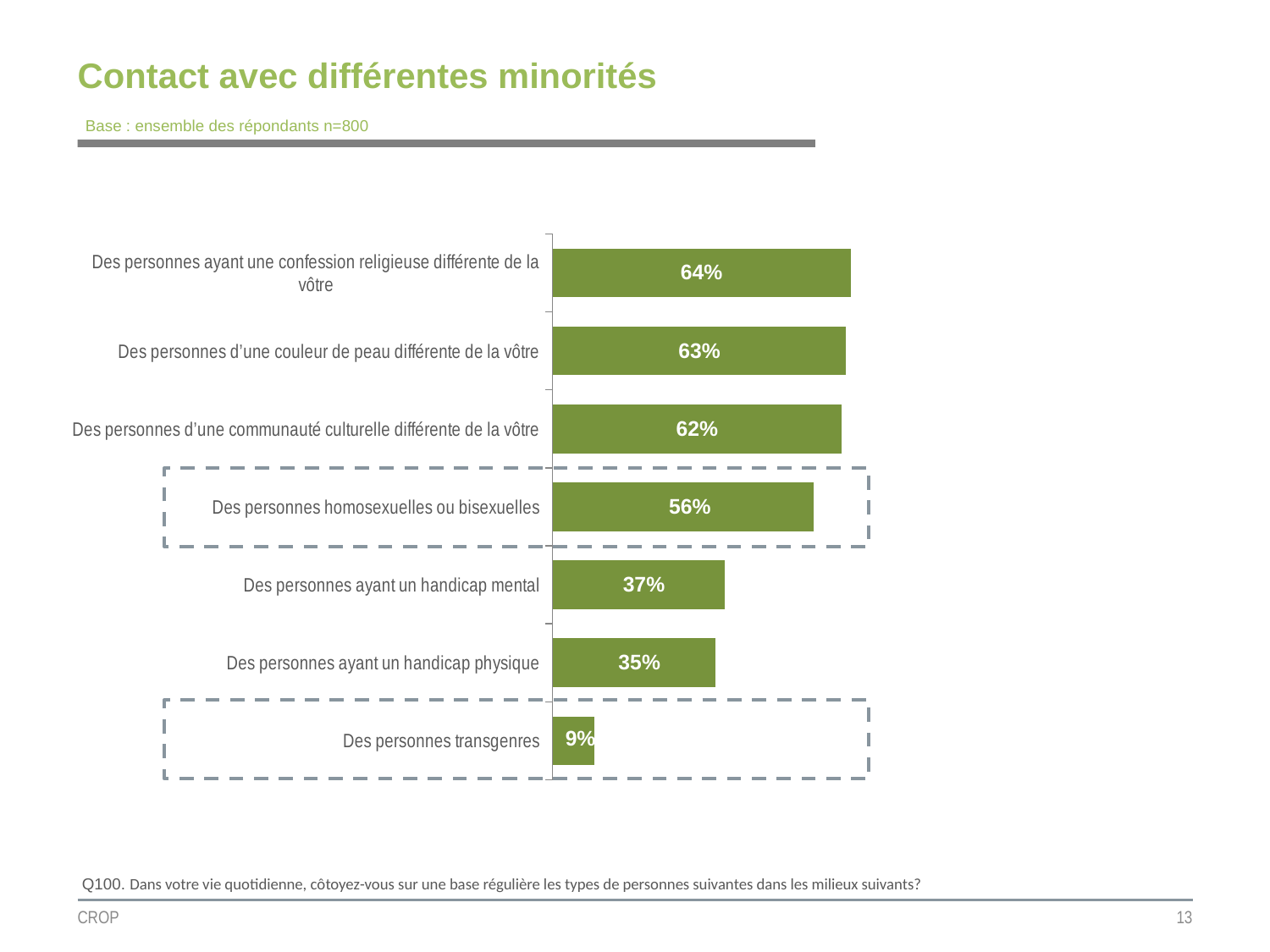
What is the value for "Des personnes ayant un handicap mental"? 37% What is the difference between the values for "Des personnes ayant un handicap mental" and "Des personnes ayant un handicap physique"? 2% What is the value for "Des personnes homosexuelles ou bisexuelles"? 56% What is the difference between the values for "Des personnes homosexuelles ou bisexuelles" and "Des personnes transgenres"? 47% Which category has the lowest value? Des personnes transgenres How many categories are shown in the chart? 7 Which category has the highest value? Des personnes ayant une confession religieuse différente de la vôtre What is the value for "Des personnes transgenres"? 9% What is the value for "Des personnes d'une communauté culturelle différente de la vôtre"? 62% Which is larger: the value for "Des personnes d'une couleur de peau différente de la vôtre" or the value for "Des personnes homosexuelles ou bisexuelles"? Des personnes d'une couleur de peau différente de la vôtre What kind of chart is shown on the slide? Bar chart Which two categories are highlighted with dashed boxes? Des personnes homosexuelles ou bisexuelles; Des personnes transgenres